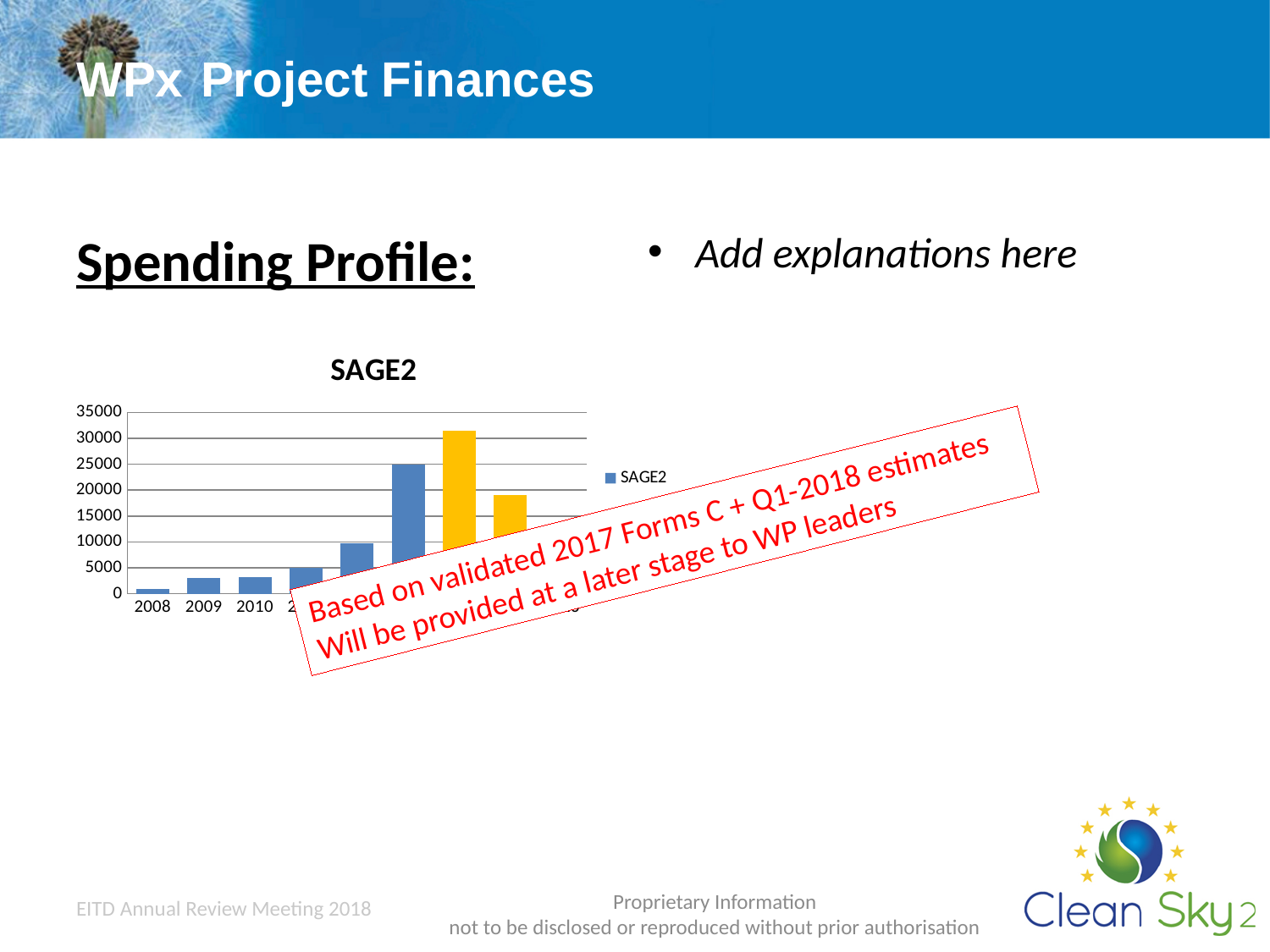
How many series does the chart legend list? 1 What is the title of the chart? SAGE2 Which is larger, the value for 2008 or the value for 2009? 2009 What type of chart is shown on the slide? bar chart Is the value of the tallest bar greater or less than 30000? greater Which is larger, the value for 2008 or the value for 2010? 2010 How many bars in the chart are coloured yellow? 2 Is the value for 2008 greater or less than 5000? less Is the value for 2009 greater or less than 5000? less What is the highest value shown on the vertical axis? 35000